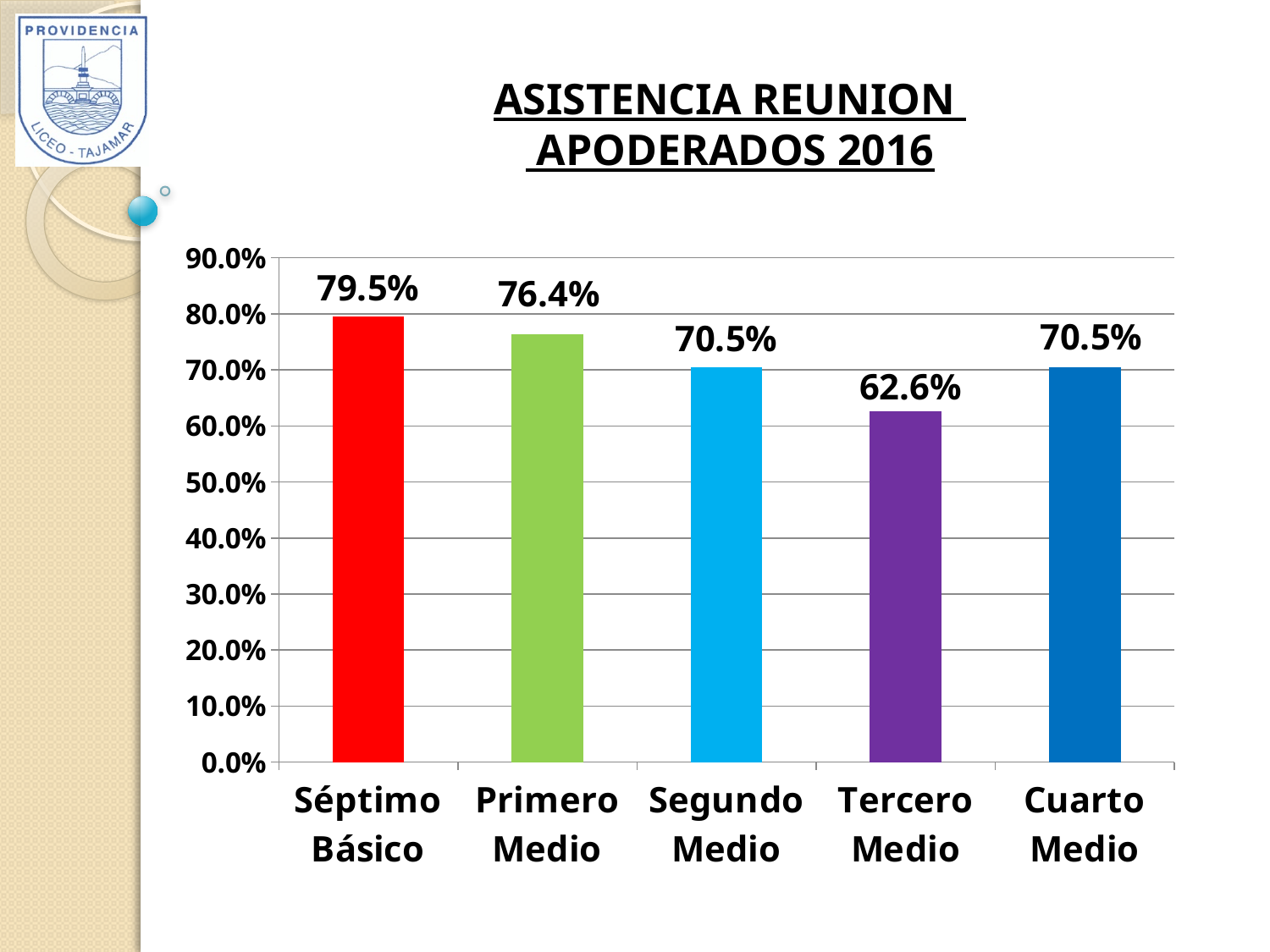
What is the attendance value for Primero Medio? 76.4% Is the value for Tercero Medio greater or less than 70.0%? less What is the attendance value for Séptimo Básico? 79.5% What is the attendance value for Tercero Medio? 62.6% What is the difference between the values for Séptimo Básico and Tercero Medio? 16.9% Which is larger, the value for Primero Medio or the value for Cuarto Medio? Primero Medio Which category has the lowest attendance? Tercero Medio How many categories are shown on the x axis? 5 What kind of chart is shown on the slide? bar chart Which category has the highest attendance? Séptimo Básico What is the difference between the values for Primero Medio and Segundo Medio? 5.9% What is the title of the chart? ASISTENCIA REUNION APODERADOS 2016